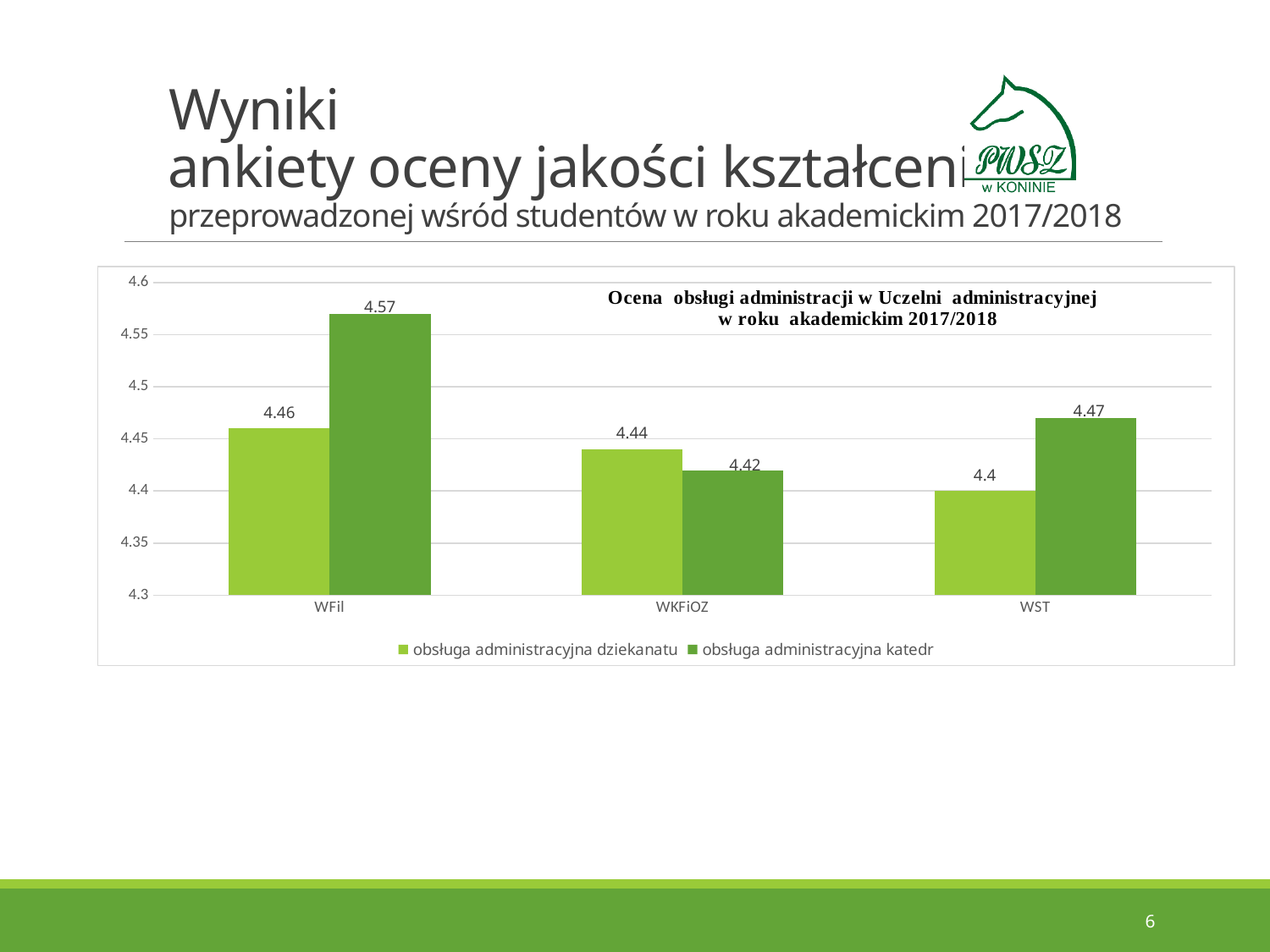
What is the value for 'obsługa administracyjna dziekanatu' at WFil? 4.46 What is the value for 'obsługa administracyjna katedr' at WST? 4.47 What kind of chart is shown on the slide? bar chart At WKFiOZ, which is larger: 'obsługa administracyjna dziekanatu' or 'obsługa administracyjna katedr'? obsługa administracyjna dziekanatu Which category has the lowest value for 'obsługa administracyjna dziekanatu'? WST What is the value for 'obsługa administracyjna katedr' at WFil? 4.57 What is the difference between 'obsługa administracyjna katedr' and 'obsługa administracyjna dziekanatu' at WFil? 0.11 How many series does the legend list? 2 How many categories are shown on the x axis? 3 Is the value for 'obsługa administracyjna katedr' at WFil greater or less than 4.5? greater What is the value for 'obsługa administracyjna dziekanatu' at WKFiOZ? 4.44 Which category has the highest value for 'obsługa administracyjna katedr'? WFil